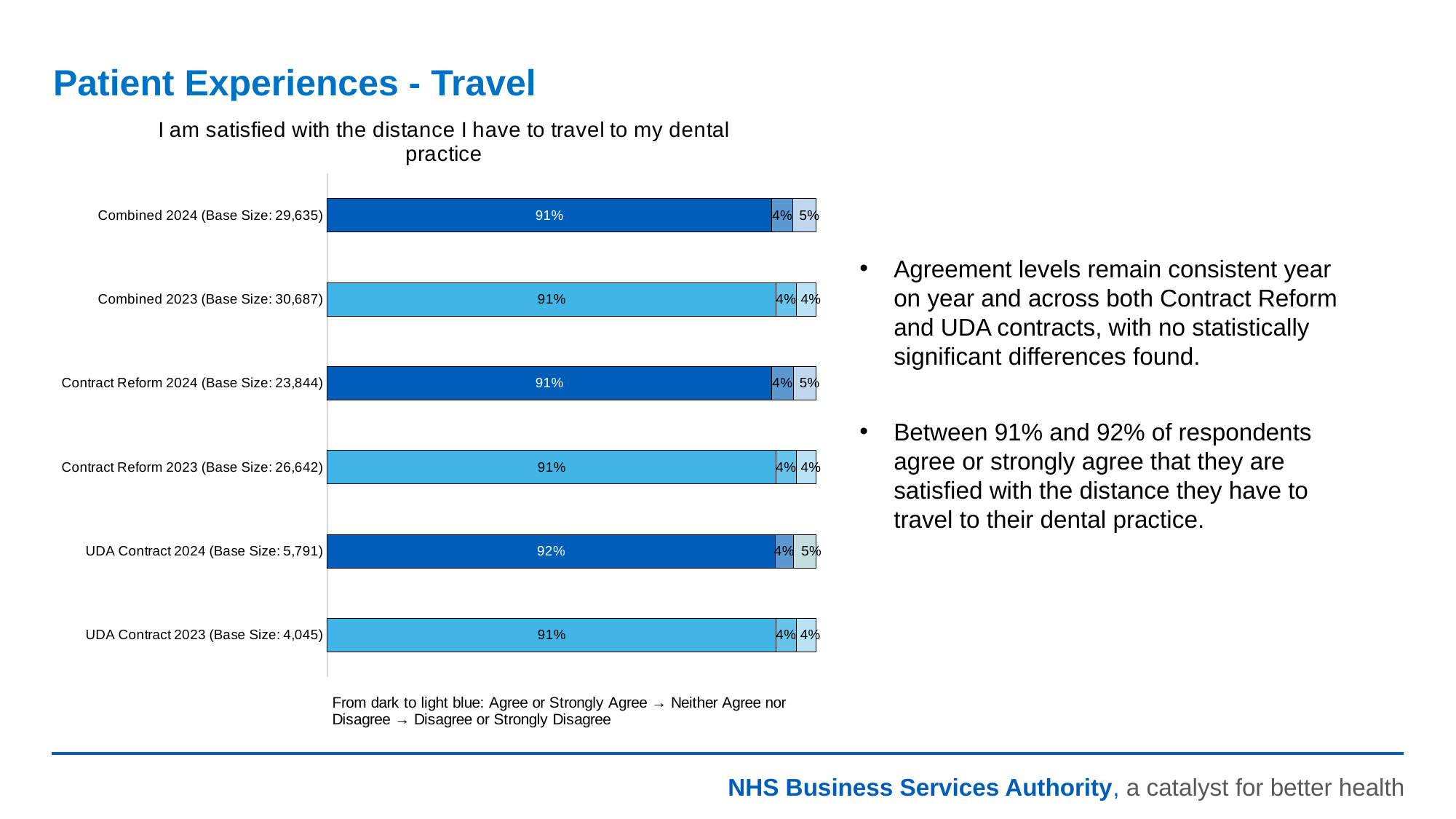
What is the total of the three segments in the Combined 2024 bar? 100% What is the title of the chart? I am satisfied with the distance I have to travel to my dental practice What is the difference between the 'Disagree or Strongly Disagree' values for Combined 2024 and Combined 2023? 1% What is the 'Disagree or Strongly Disagree' value for UDA Contract 2024? 5% What is the total of the three segments in the Contract Reform 2023 bar? 99% How many categories (bars) are shown in the chart? 6 What is the 'Neither Agree nor Disagree' value for Contract Reform 2023? 4% What is the base size shown for Contract Reform 2024? 23,844 Which has a larger 'Agree or Strongly Agree' value, UDA Contract 2024 or UDA Contract 2023? UDA Contract 2024 What kind of chart is shown on the slide? Stacked bar chart Which category has the highest 'Agree or Strongly Agree' percentage? UDA Contract 2024 What percentage of Combined 2024 respondents agree or strongly agree that they are satisfied with the distance they have to travel? 91%